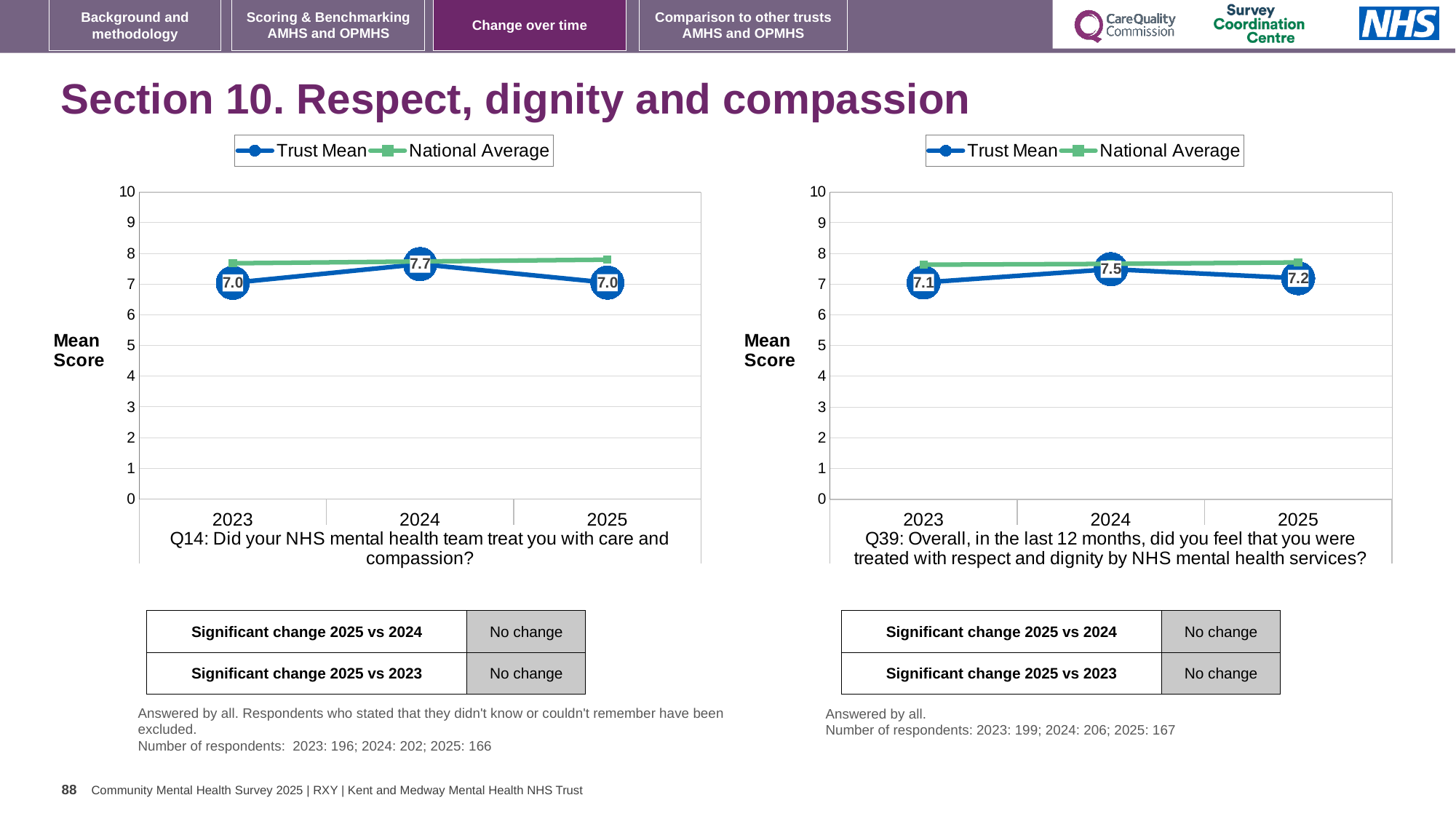
In the Q39 chart (right), what is the Trust Mean for 2023? 7.1 How many series does the legend of the Q39 chart (right) list? 2 In the Q14 chart (left), what is the Trust Mean for 2025? 7.0 In the Q14 chart (left), what is the Trust Mean for 2024? 7.7 In the Q39 chart (right), what is the difference between the Trust Mean for 2024 and the Trust Mean for 2025? 0.3 In the Q14 chart (left), what is the difference between the Trust Mean for 2024 and the Trust Mean for 2023? 0.7 In the Q39 chart (right), which year has the lowest Trust Mean? 2023 In the Q14 chart (left), which year has the highest Trust Mean? 2024 In the Q39 chart (right), what is the Trust Mean for 2025? 7.2 What kind of chart is the Q14 chart (left)? Line chart In the Q14 chart (left), is the National Average for 2023 greater or less than 7? greater In the Q39 chart (right), is the Trust Mean for 2024 larger or smaller than the Trust Mean for 2023? larger